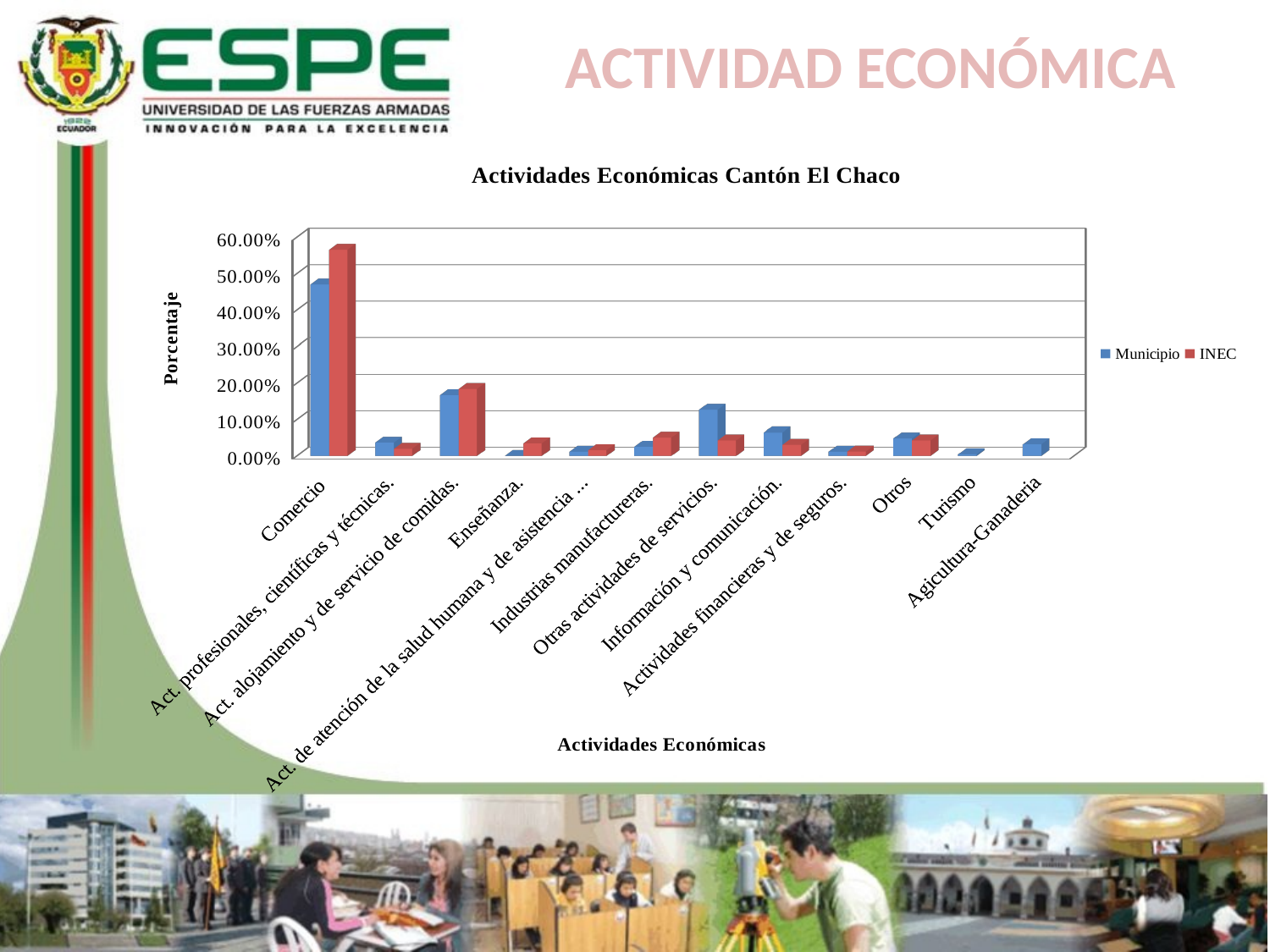
Which category has the highest value for the INEC series? Comercio Is the Municipio value for Comercio greater or less than 40.00%? greater What is the title of the chart? Actividades Económicas Cantón El Chaco Is the Municipio value for Otras actividades de servicios greater or less than 10.00%? greater What type of chart is shown on the slide? Bar chart For Otras actividades de servicios, which series has the larger value, Municipio or INEC? Municipio Which category has the highest value for the Municipio series? Comercio What is the label of the vertical axis? Porcentaje Is the INEC value for Comercio greater or less than 50.00%? greater For Comercio, which series has the larger value, Municipio or INEC? INEC How many economic activity categories are shown on the x axis? 12 How many series does the legend list? 2